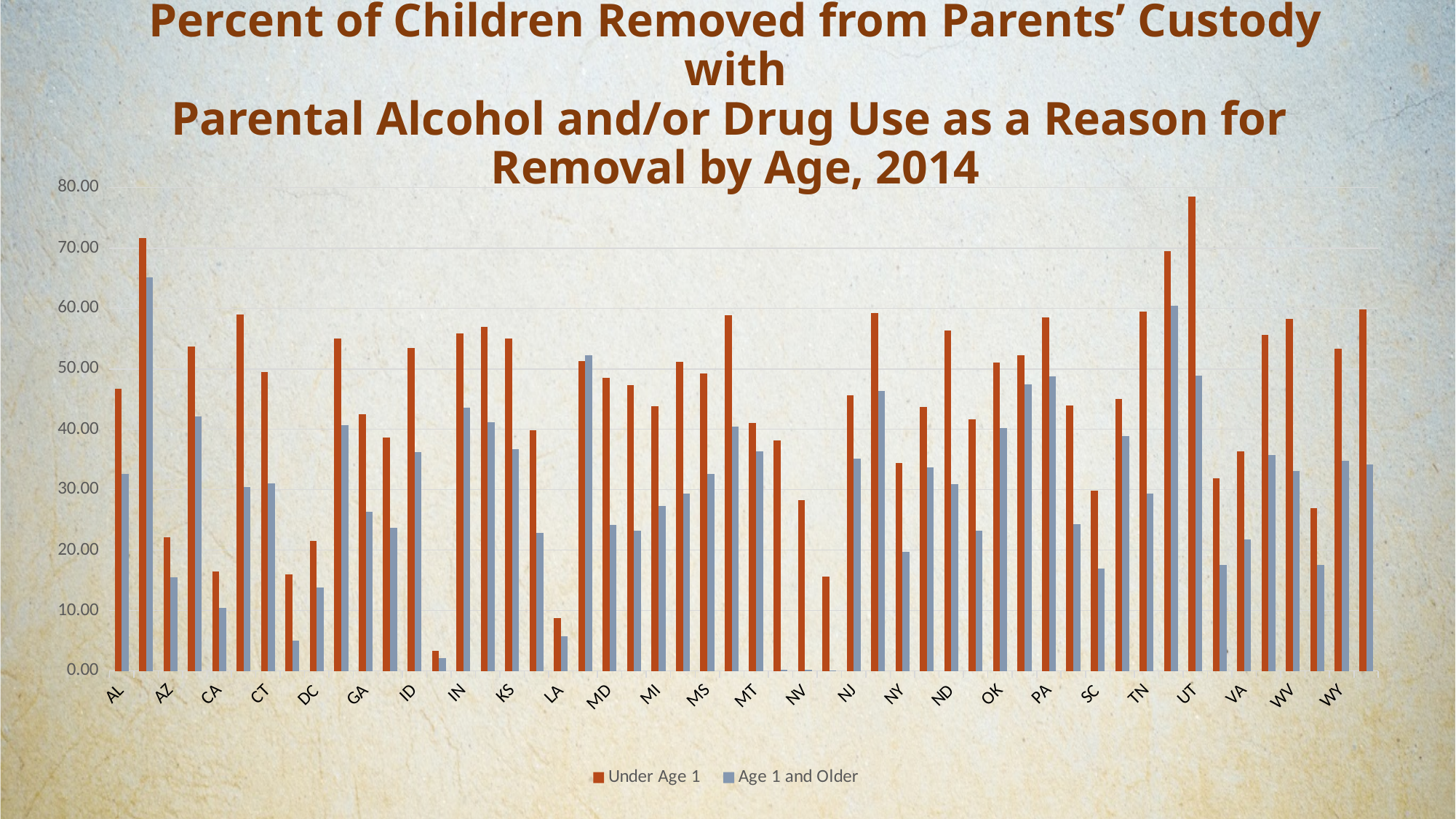
Which has the larger Under Age 1 value, AZ or CA? AZ For MD, which is larger: the Under Age 1 value or the Age 1 and Older value? Under Age 1 How many series does the legend list? 2 Is the Under Age 1 value for CA greater or less than 20.00? less What kind of chart is shown on the slide? Bar chart Is the Under Age 1 value for UT greater or less than 70.00? greater Is the Age 1 and Older value for PA greater or less than 40.00? greater Which colour represents the Under Age 1 series? Orange What are the two series named in the legend? Under Age 1; Age 1 and Older Which state has the highest Under Age 1 value? UT